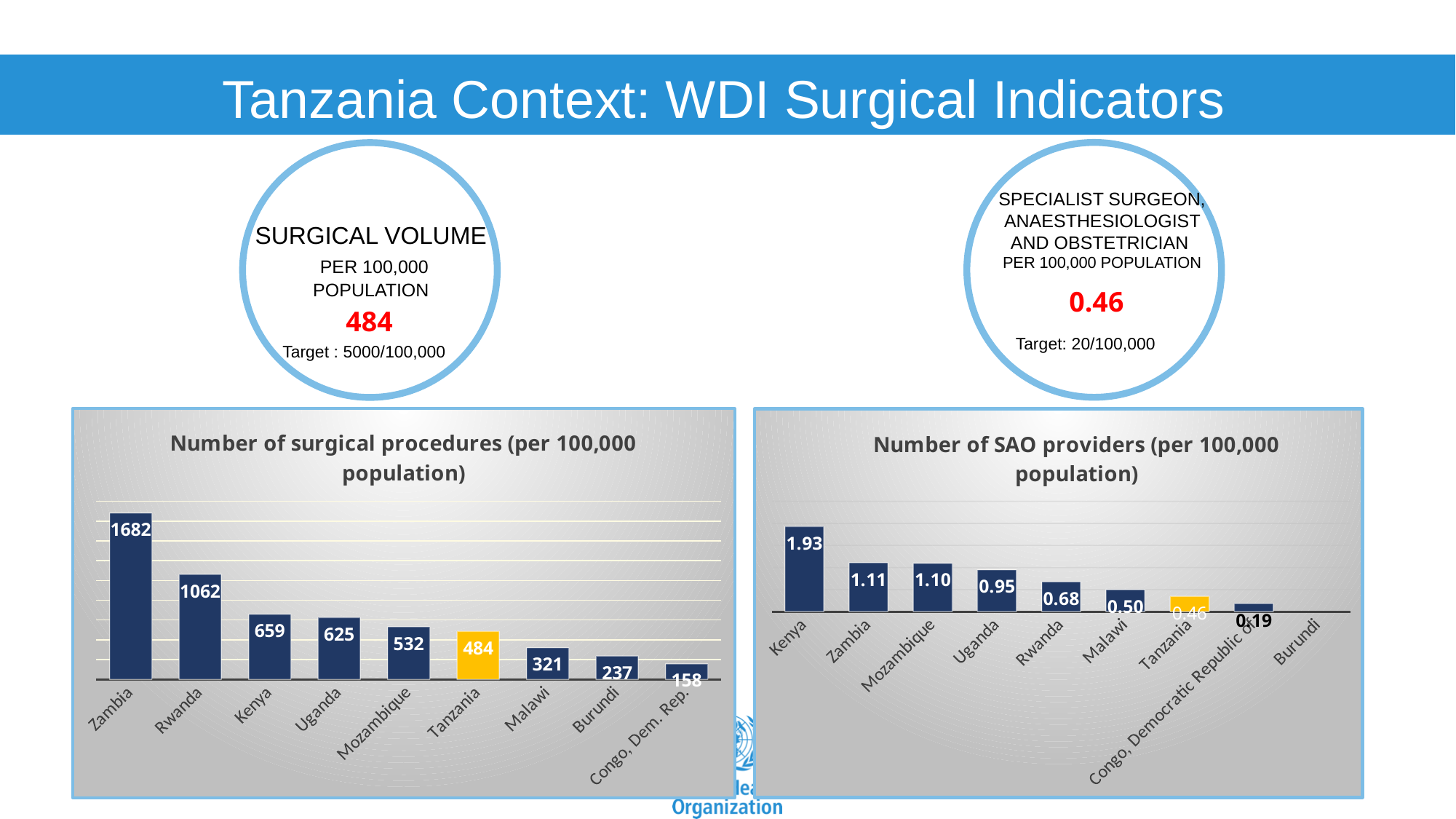
In the 'Number of surgical procedures (per 100,000 population)' chart, which country's bar is highlighted in yellow? Tanzania In the 'Number of SAO providers (per 100,000 population)' chart, what is the value for Kenya? 1.93 In the 'Number of surgical procedures (per 100,000 population)' chart, what is the difference between Zambia and Rwanda? 620 In the 'Number of surgical procedures (per 100,000 population)' chart, which country has the lowest value? Congo, Dem. Rep. In the 'Number of SAO providers (per 100,000 population)' chart, what is the value for Tanzania? 0.46 In the 'Number of surgical procedures (per 100,000 population)' chart, what is the value for Tanzania? 484 In the 'Number of surgical procedures (per 100,000 population)' chart, which is larger, Malawi or Burundi? Malawi In the 'Number of surgical procedures (per 100,000 population)' chart, which country has the highest value? Zambia In the 'Number of SAO providers (per 100,000 population)' chart, what is the difference between Uganda and Rwanda? 0.27 In the 'Number of SAO providers (per 100,000 population)' chart, which country has the highest value? Kenya What type of chart is the 'Number of SAO providers (per 100,000 population)' chart? Bar chart In the 'Number of surgical procedures (per 100,000 population)' chart, how many countries are shown? 9